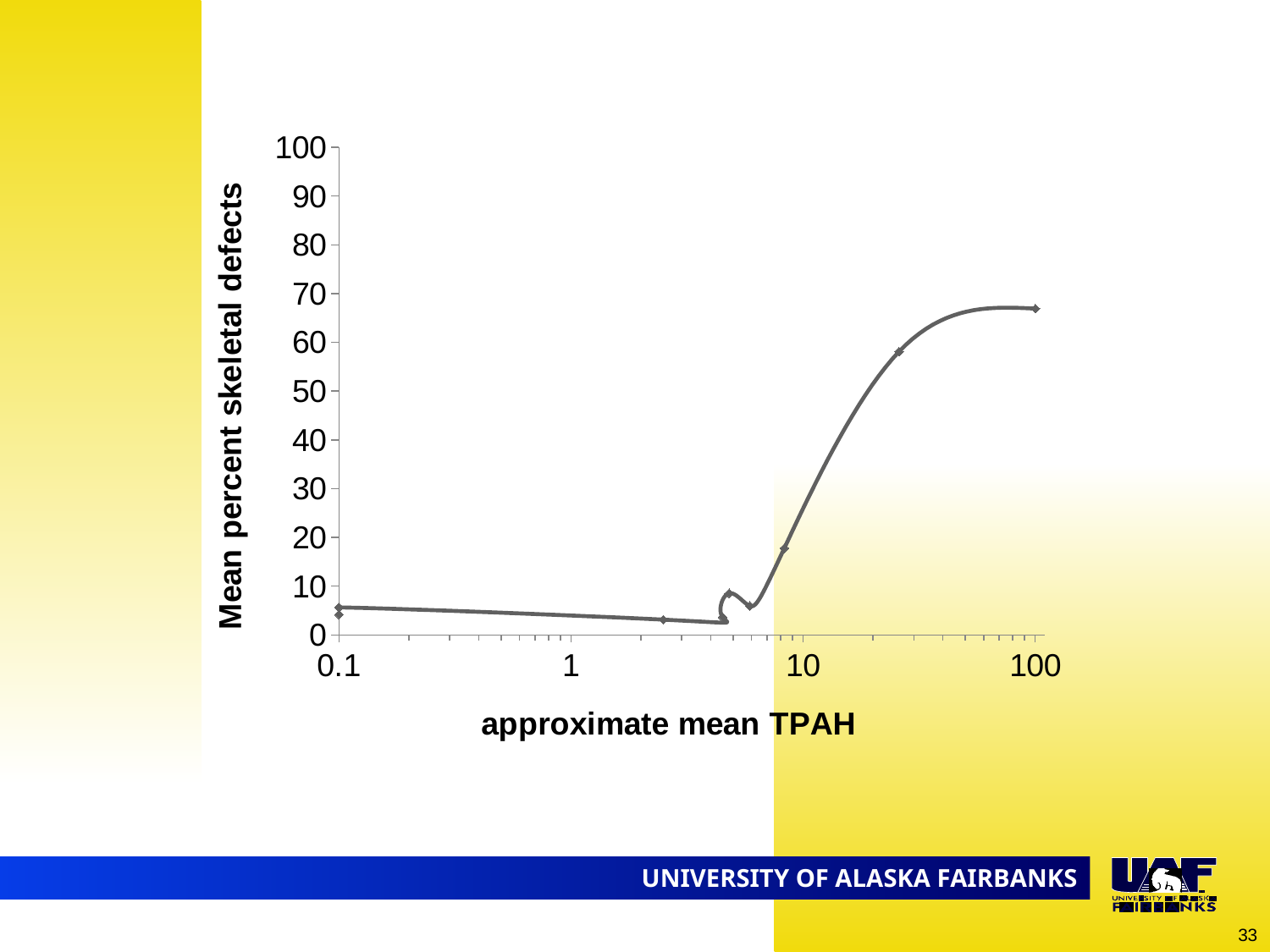
Is the value of the highest point at an approximate mean TPAH of 0.1 greater or less than 10? less Is the value of the point at an approximate mean TPAH of 100 greater or less than 60? greater What kind of chart is shown on the slide? line chart Which has the larger mean percent skeletal defects: the point at an approximate mean TPAH of 0.1 or the point at 100? the point at 100 Overall, do the mean percent skeletal defects rise or fall as approximate mean TPAH increases from 0.1 to 100? rise Is the value of the point plotted just below 10 on the x axis greater or less than 20? less What is the label of the y axis? Mean percent skeletal defects What is the label of the x axis? approximate mean TPAH What is the highest value shown on the y axis? 100 At which approximate mean TPAH value does the curve reach its highest mean percent skeletal defects? 100